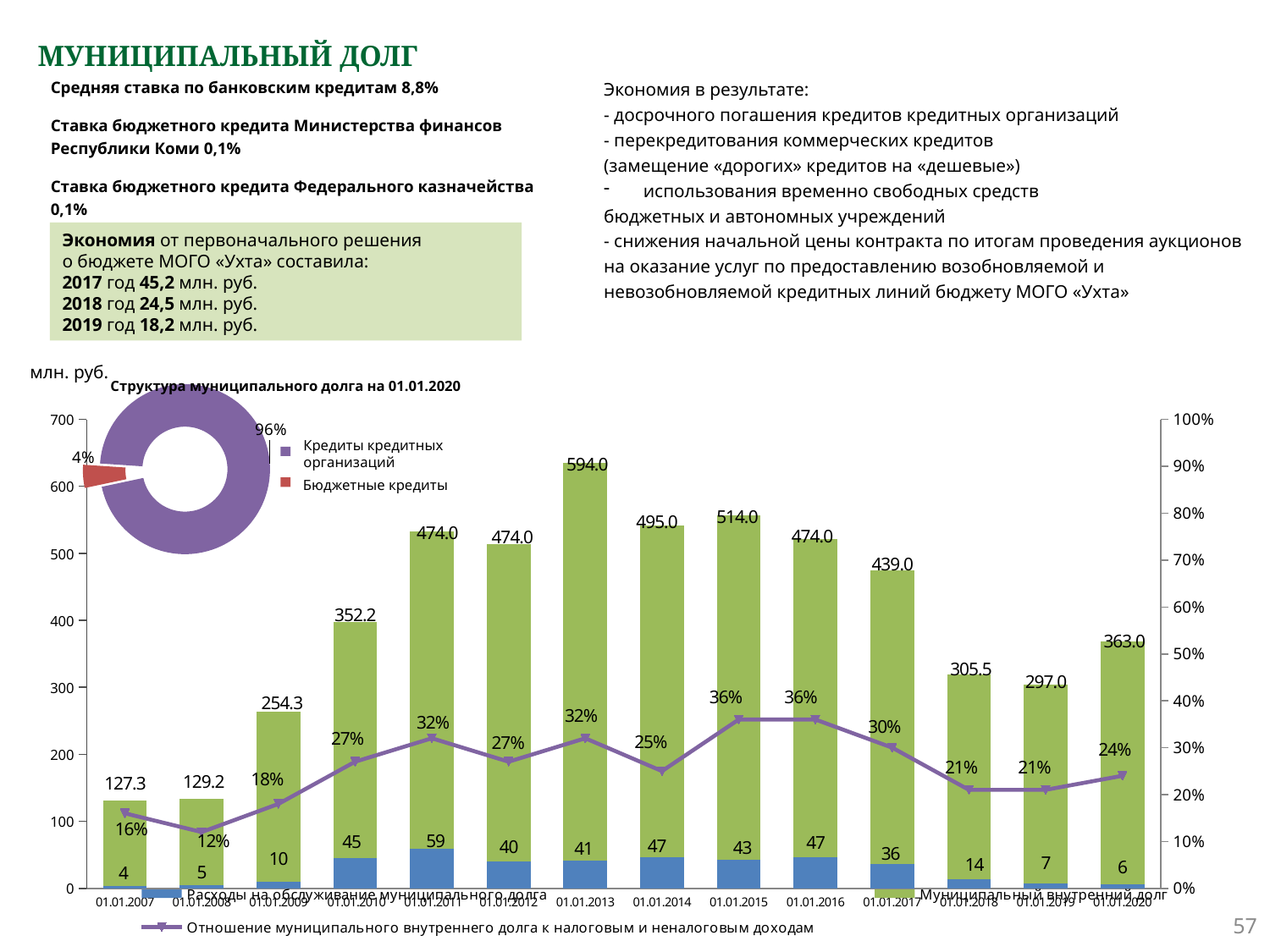
In the main chart, what is the ratio of municipal internal debt to tax and non-tax revenues on 01.01.2015? 36% How many dates (categories) are shown on the x axis of the main chart? 14 In the main chart, what is the value of the municipal internal debt (Муниципальный внутренний долг) on 01.01.2013? 594.0 What type of chart is the main chart at the bottom of the slide? Stacked bar chart with a line In the donut chart, what share is Бюджетные кредиты? 4% In the main chart, what are the debt servicing expenses (Расходы на обслуживание муниципального долга) on 01.01.2011? 59 In the main chart, on which date is the municipal internal debt highest? 01.01.2013 In the main chart, on which date is the municipal internal debt lowest? 01.01.2007 In the main chart, which is larger: the municipal internal debt on 01.01.2014 or on 01.01.2015? 01.01.2015 How many series does the legend of the main chart list? 3 In the main chart, by how much does the municipal internal debt on 01.01.2020 exceed that on 01.01.2019? 66.0 In the donut chart 'Структура муниципального долга на 01.01.2020', what share is Кредиты кредитных организаций? 96%